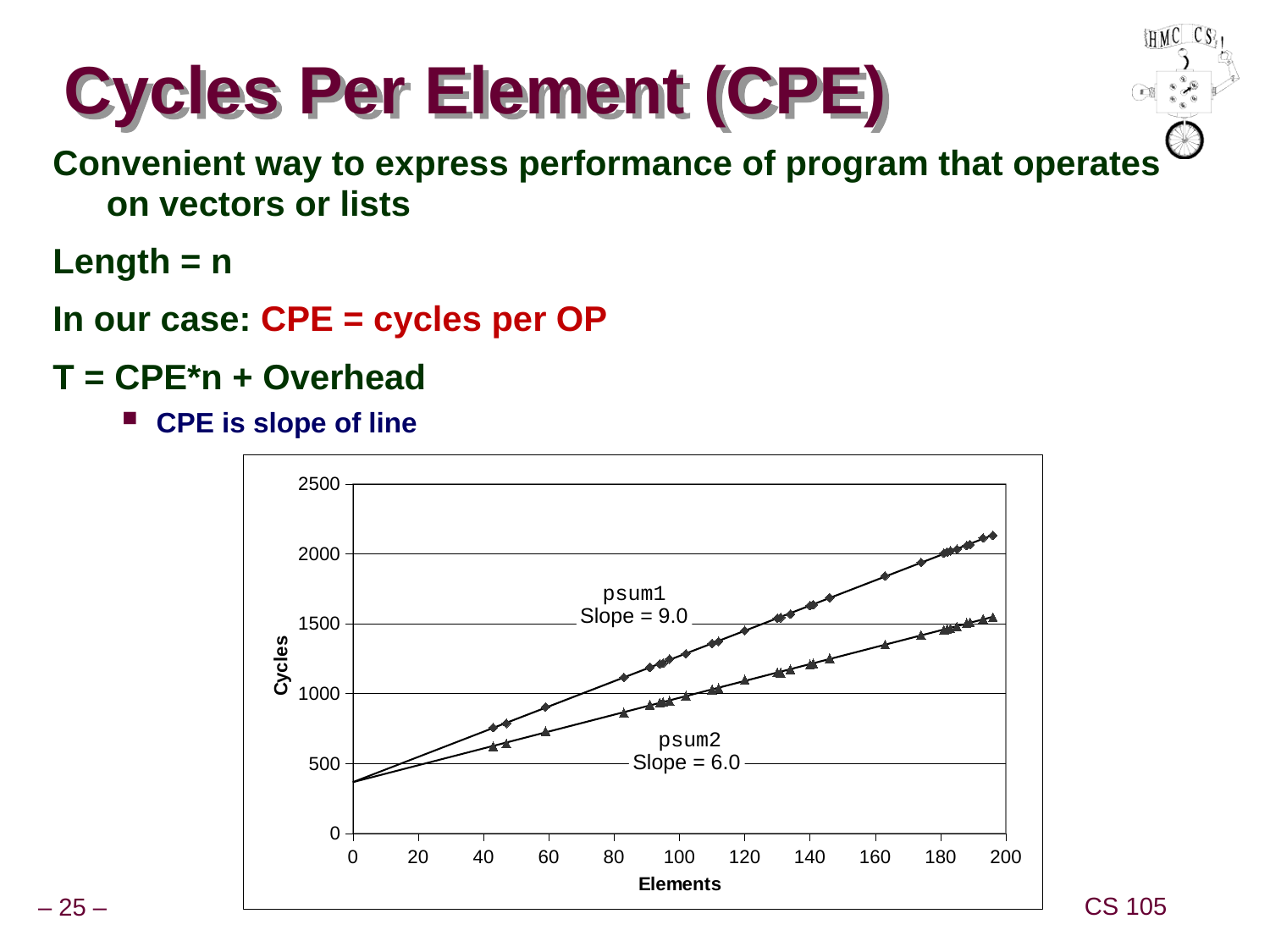
How many data series are plotted on the chart? 2 Is the value for psum2 at about 190 elements greater or less than 2000 cycles? less What is the label on the x axis of the chart? Elements What is the label on the y axis of the chart? Cycles Which series has the larger slope, psum1 or psum2? psum1 Is the value for psum1 at about 190 elements greater or less than 2000 cycles? greater Is the value for psum1 at about 100 elements greater or less than 1000 cycles? greater Do the cycle counts rise or fall as the number of elements increases? rise What is the slope printed for the psum2 series? 6.0 What is the difference between the slopes of psum1 and psum2? 3.0 What kind of chart is shown on the slide? line chart What is the slope printed for the psum1 series? 9.0